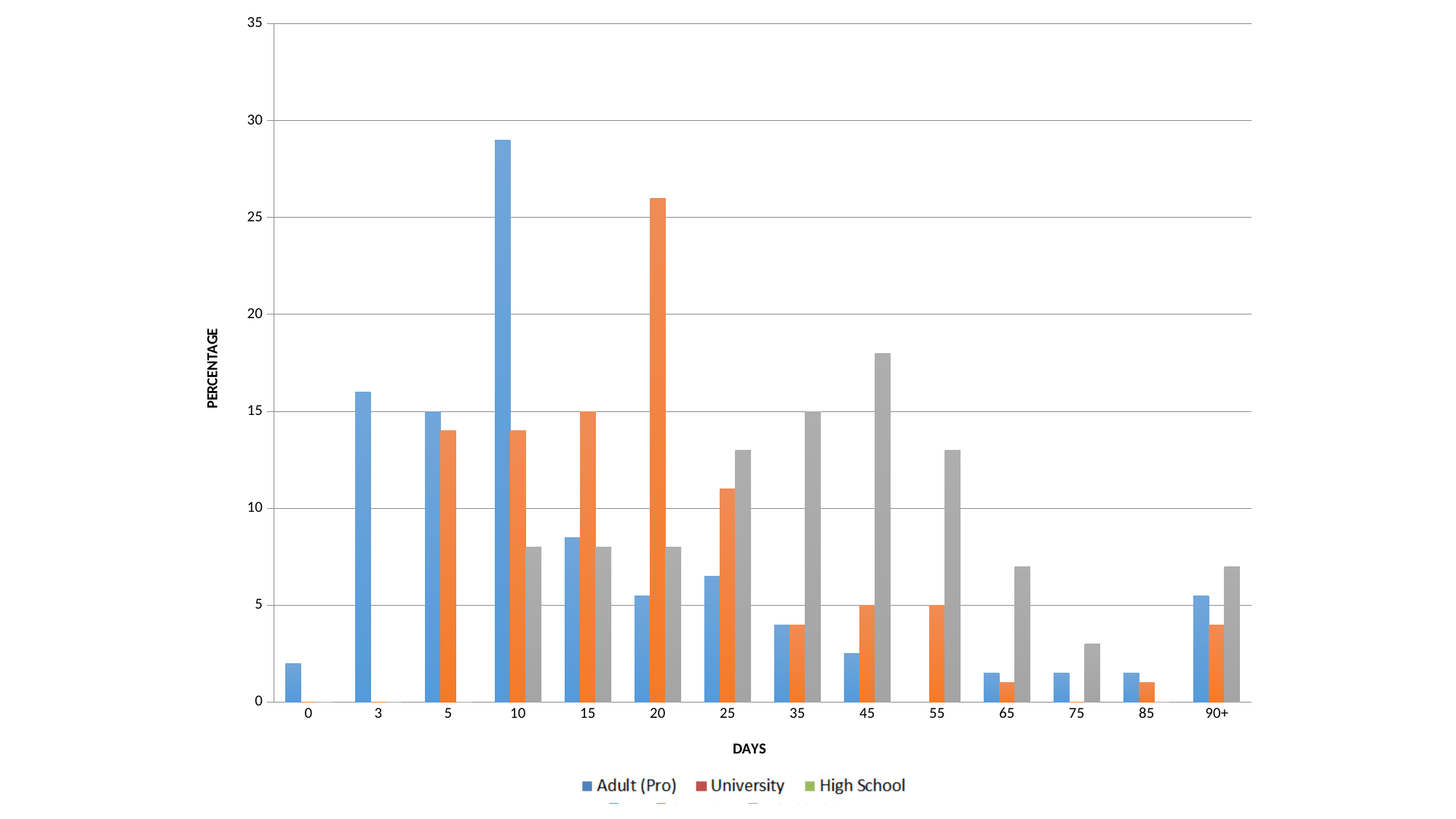
At which number of days is the University series highest? 20 What is the Adult (Pro) value at 5 days? 15 How many categories are shown on the DAYS axis? 14 What is the High School value at 35 days? 15 At which number of days is the High School series highest? 45 What is the University value at 15 days? 15 Is the Adult (Pro) value at 10 days greater or less than 25? greater What kind of chart is shown on the slide? Bar chart How many series does the legend list? 3 At which number of days is the Adult (Pro) series highest? 10 At 45 days, which is larger: the High School value or the University value? High School What is the title of the vertical axis? PERCENTAGE